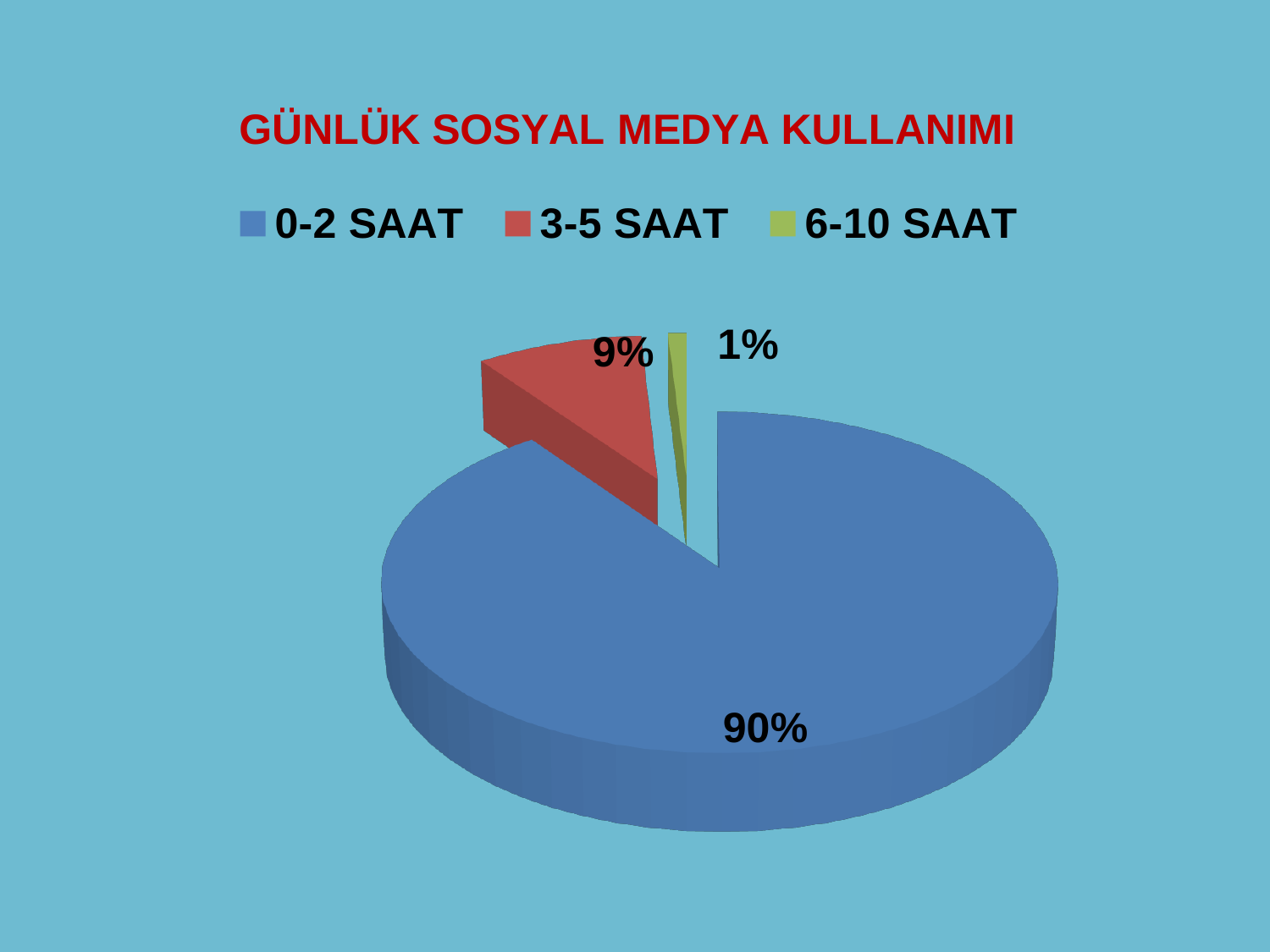
Which is larger, the 3-5 SAAT slice or the 6-10 SAAT slice? 3-5 SAAT What is the title of the chart? GÜNLÜK SOSYAL MEDYA KULLANIMI Which category has the smallest slice of the pie? 6-10 SAAT How many entries does the legend list? 3 What share of the pie does the 6-10 SAAT slice represent? 1% What is the difference in percentage points between the 0-2 SAAT slice and the 3-5 SAAT slice? 81 percentage points What share of the pie does the 3-5 SAAT slice represent? 9% What kind of chart is shown on the slide? Pie chart How many categories does the pie chart show? 3 Which category has the largest slice of the pie? 0-2 SAAT What share of the pie does the 0-2 SAAT slice represent? 90% What colour is the 3-5 SAAT slice? Red